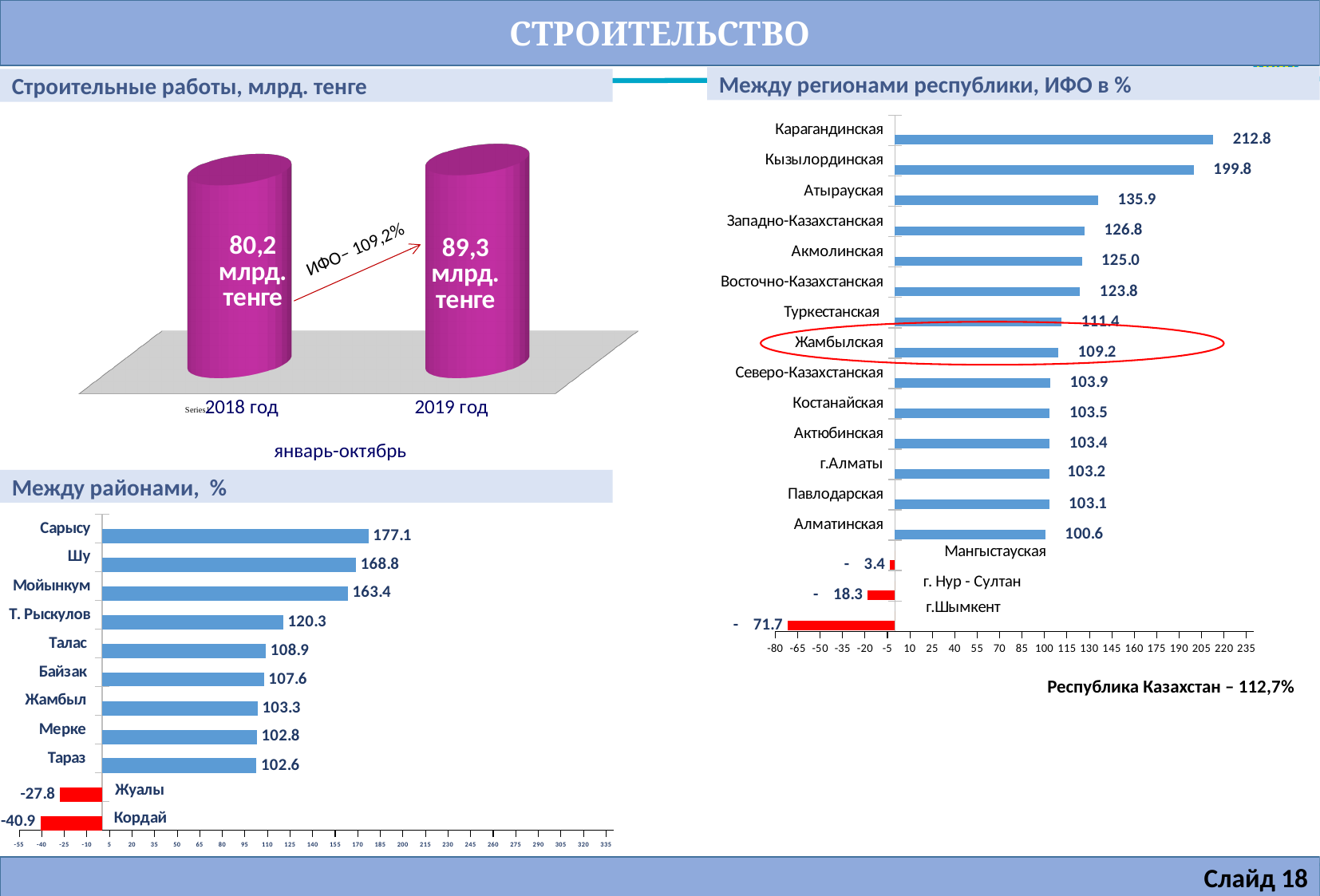
On the chart 'Между районами, %', how many categories are shown? 11 On the chart 'Между регионами республики, ИФО в %', which is larger: the value for Атырауская or the value for Акмолинская? Атырауская On the chart 'Между регионами республики, ИФО в %', what is the value for Жамбылская? 109.2 On the chart 'Строительные работы, млрд. тенге', what is the value for 2018 год? 80,2 млрд. тенге On the chart 'Строительные работы, млрд. тенге', what is the value for 2019 год? 89,3 млрд. тенге On the chart 'Между регионами республики, ИФО в %', which region has the highest value? Карагандинская On the chart 'Между регионами республики, ИФО в %', which category has the lowest value? г.Шымкент On the chart 'Между районами, %', which category has the highest value? Сарысу On the chart 'Между районами, %', what is the value for Мойынкум? 163.4 What kind of chart is 'Между регионами республики, ИФО в %'? Bar chart On the chart 'Между районами, %', which category has the lowest value? Кордай On the chart 'Между районами, %', what is the difference between the values for Сарысу and Шу? 8.3